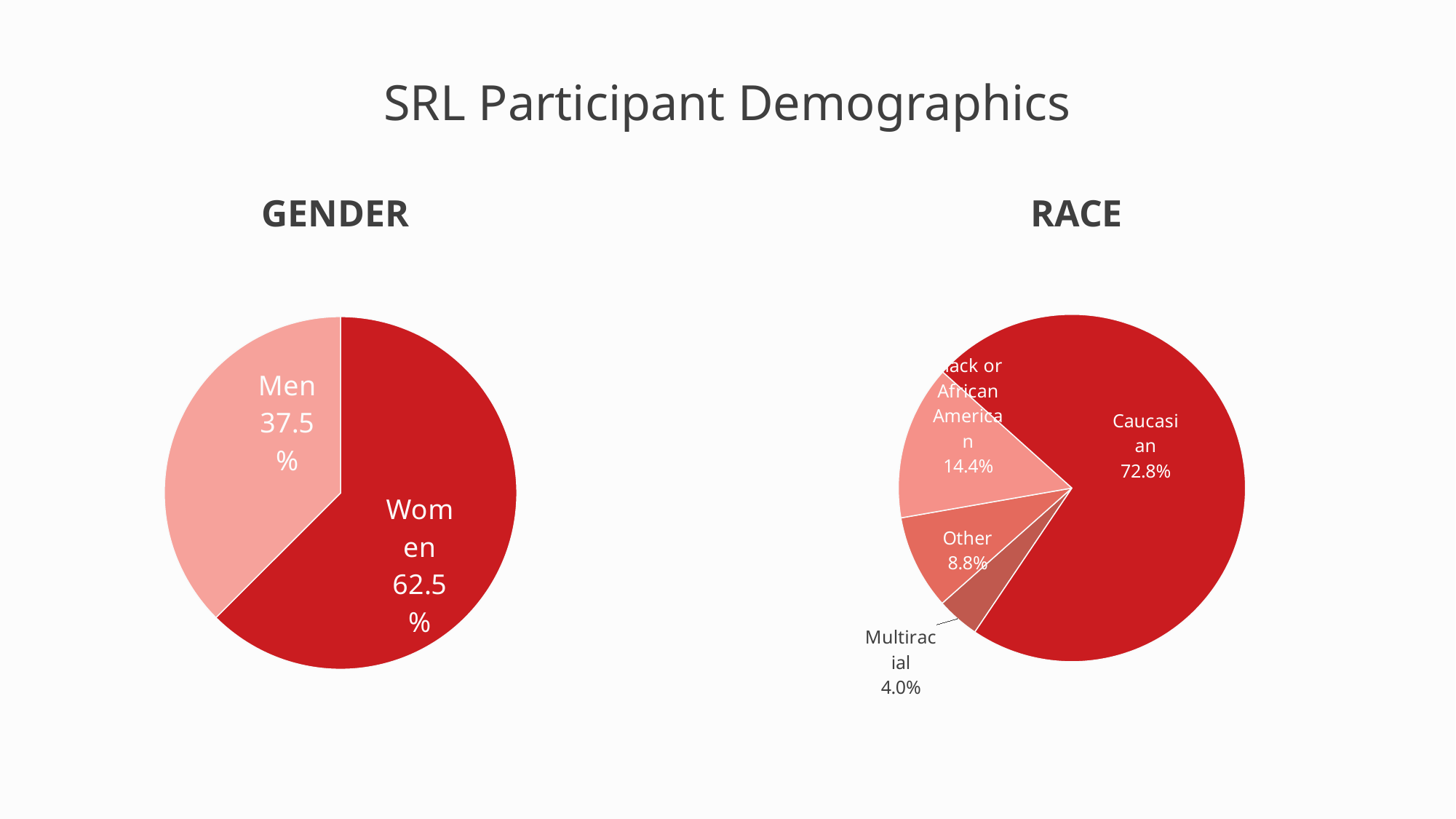
What kind of chart is the GENDER chart? Pie chart In the RACE chart, what is the difference between the Other and Multiracial shares? 4.8% In the GENDER chart, which group has the larger share, Men or Women? Women In the RACE chart, what percentage of participants are Caucasian? 72.8% In the RACE chart, what percentage of participants are Black or African American? 14.4% In the RACE chart, which category has the largest share? Caucasian In the GENDER chart, what is the difference between the Women and Men shares? 25% In the RACE chart, which category has the smallest share? Multiracial How many categories are shown in the RACE chart? 4 In the GENDER chart, what percentage of participants are women? 62.5% In the RACE chart, what percentage of participants are Multiracial? 4.0% In the GENDER chart, what percentage of participants are men? 37.5%